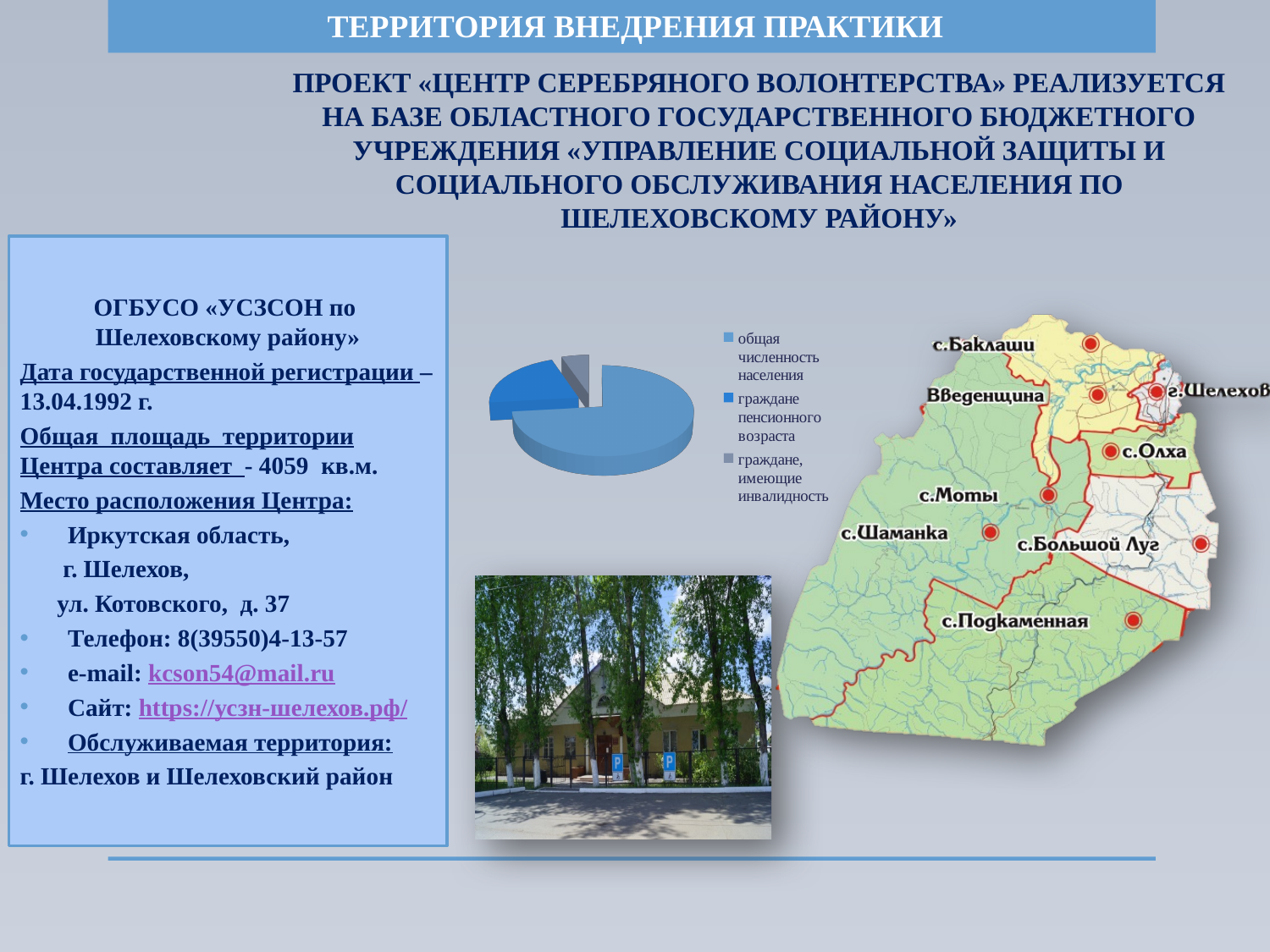
How many entries does the legend of the pie chart list? 3 What is the first entry listed in the pie chart's legend? общая численность населения Which category has the largest slice in the pie chart? общая численность населения Which slice is larger in the pie chart: "граждане пенсионного возраста" or "граждане, имеющие инвалидность"? граждане пенсионного возраста What kind of chart is shown on the slide? pie chart How many slices does the pie chart have? 3 Which slice is larger in the pie chart: "общая численность населения" or "граждане пенсионного возраста"? общая численность населения What colour is the slice for "граждане, имеющие инвалидность" in the pie chart? grey Which category has the smallest slice in the pie chart? граждане, имеющие инвалидность